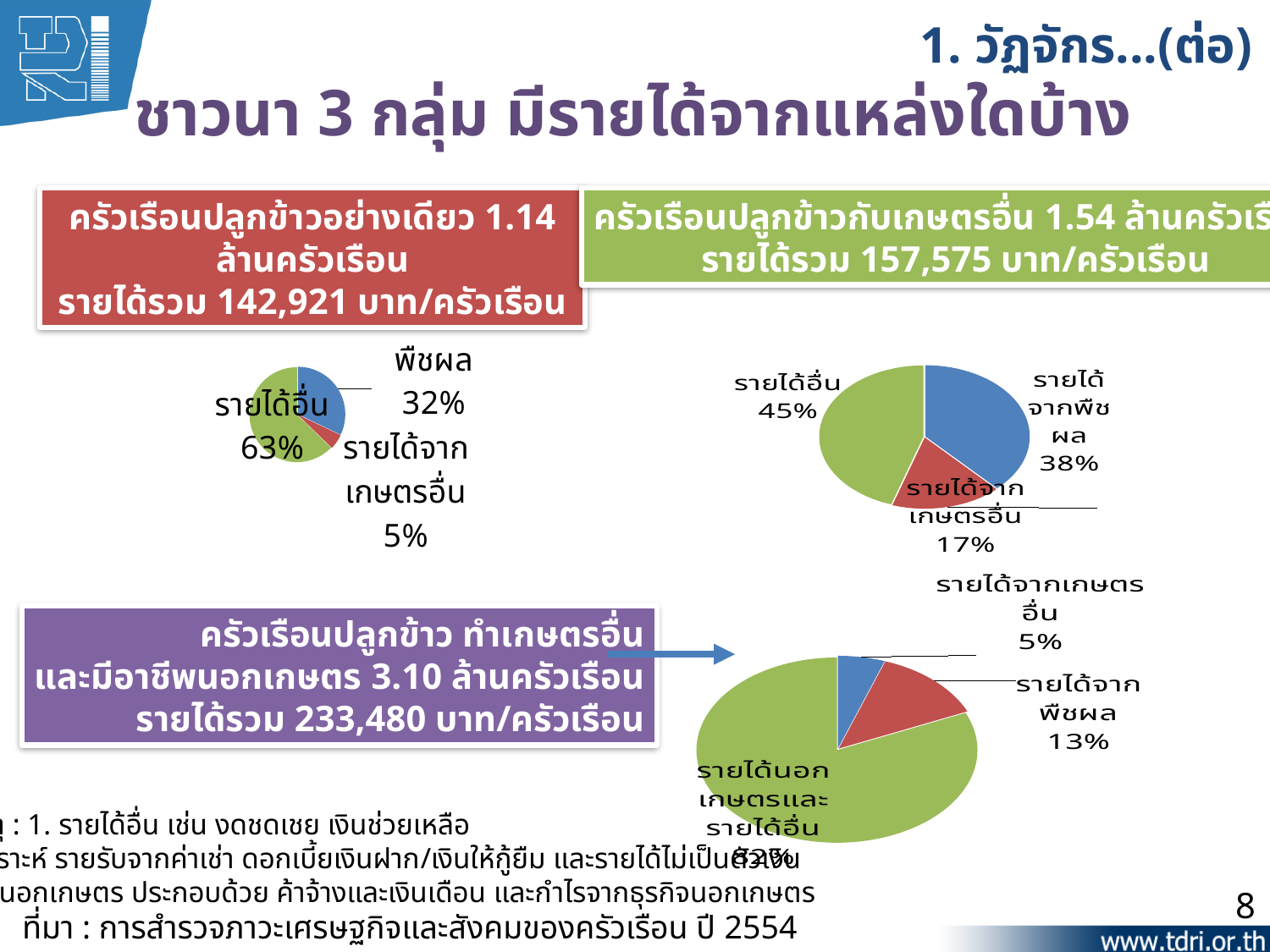
How many slices does the top-left pie chart have? 3 In the bottom-right pie chart (households with rice, other agriculture and non-farm occupations), which slice is the smallest? รายได้จากเกษตรอื่น Which is larger: the รายได้จากเกษตรอื่น share in the top-left pie chart or in the top-right pie chart? Top-right pie chart In the top-left pie chart (households growing rice only), which slice is the largest? รายได้อื่น In the top-right pie chart, how many percentage points larger is รายได้อื่น than รายได้จากพืชผล? 7 percentage points In the top-right pie chart (households growing rice with other agriculture), which slice is the largest? รายได้อื่น In the top-left pie chart (households growing rice only), what share is labelled รายได้จากเกษตรอื่น? 5% What type of chart is the top-left chart (households growing rice only)? Pie chart In the top-left pie chart (households growing rice only), what share is labelled พืชผล? 32% In the bottom-right pie chart (households with rice, other agriculture and non-farm occupations), what share is labelled รายได้จากพืชผล? 13% In the top-right pie chart (households growing rice with other agriculture), what share is labelled รายได้จากพืชผล? 38% In the top-right pie chart (households growing rice with other agriculture), what share is labelled รายได้จากเกษตรอื่น? 17%